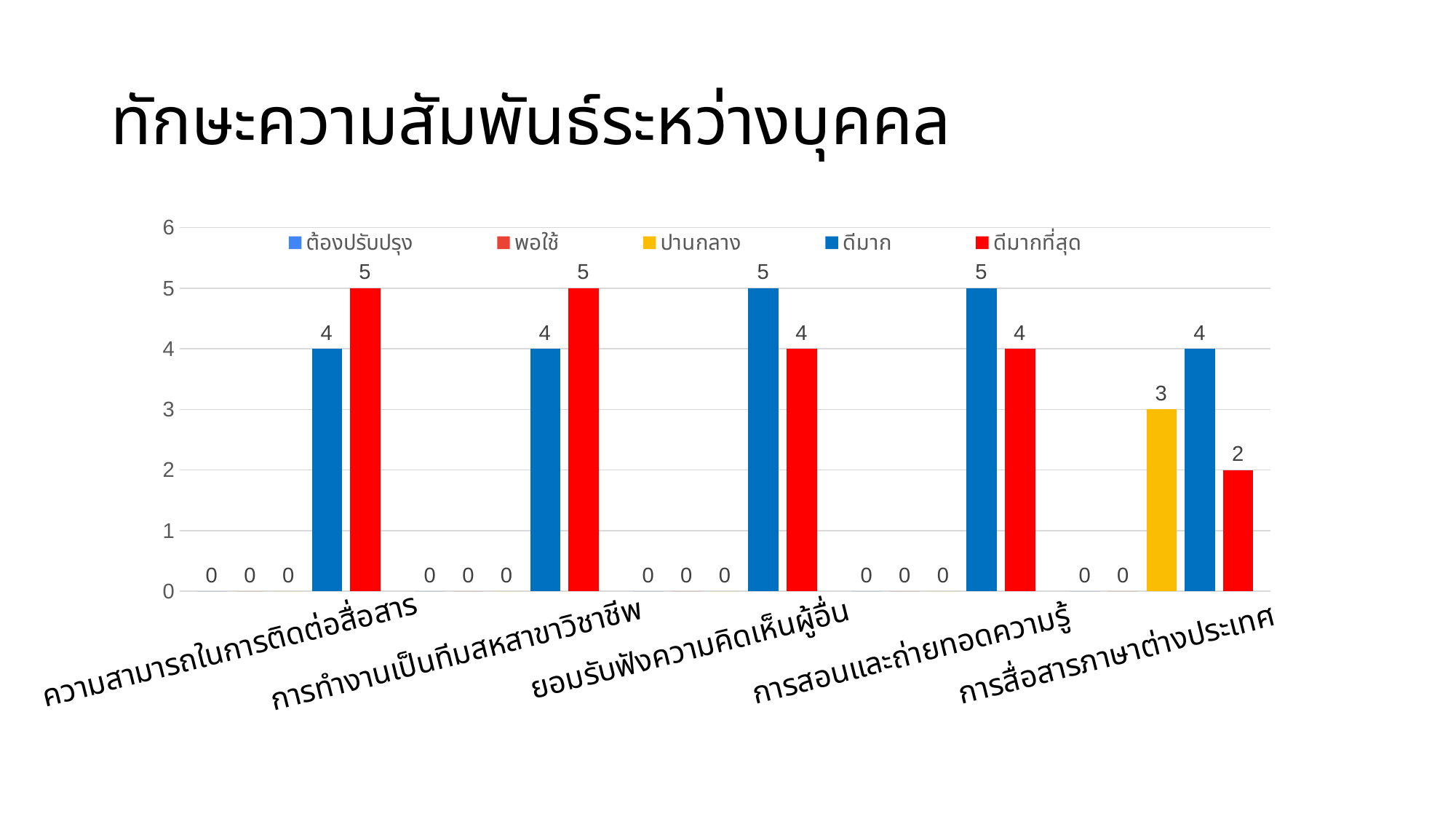
What is the value of ต้องปรับปรุง for การสอนและถ่ายทอดความรู้? 0 How many series does the legend list? 5 What is the difference between ดีมาก and ดีมากที่สุด for การสอนและถ่ายทอดความรู้? 1 What is the value of ดีมากที่สุด for ความสามารถในการติดต่อสื่อสาร? 5 What is the value of ดีมากที่สุด for การสื่อสารภาษาต่างประเทศ? 2 What is the value of ดีมาก for ยอมรับฟังความคิดเห็นผู้อื่น? 5 How many categories are shown on the x axis? 5 For การทำงานเป็นทีมสหสาขาวิชาชีพ, which is larger: ดีมาก or ดีมากที่สุด? ดีมากที่สุด What kind of chart is shown on the slide? Bar chart What is the title of the slide? ทักษะความสัมพันธ์ระหว่างบุคคล What is the value of ปานกลาง for การสื่อสารภาษาต่างประเทศ? 3 Which category has the lowest value for ดีมากที่สุด? การสื่อสารภาษาต่างประเทศ